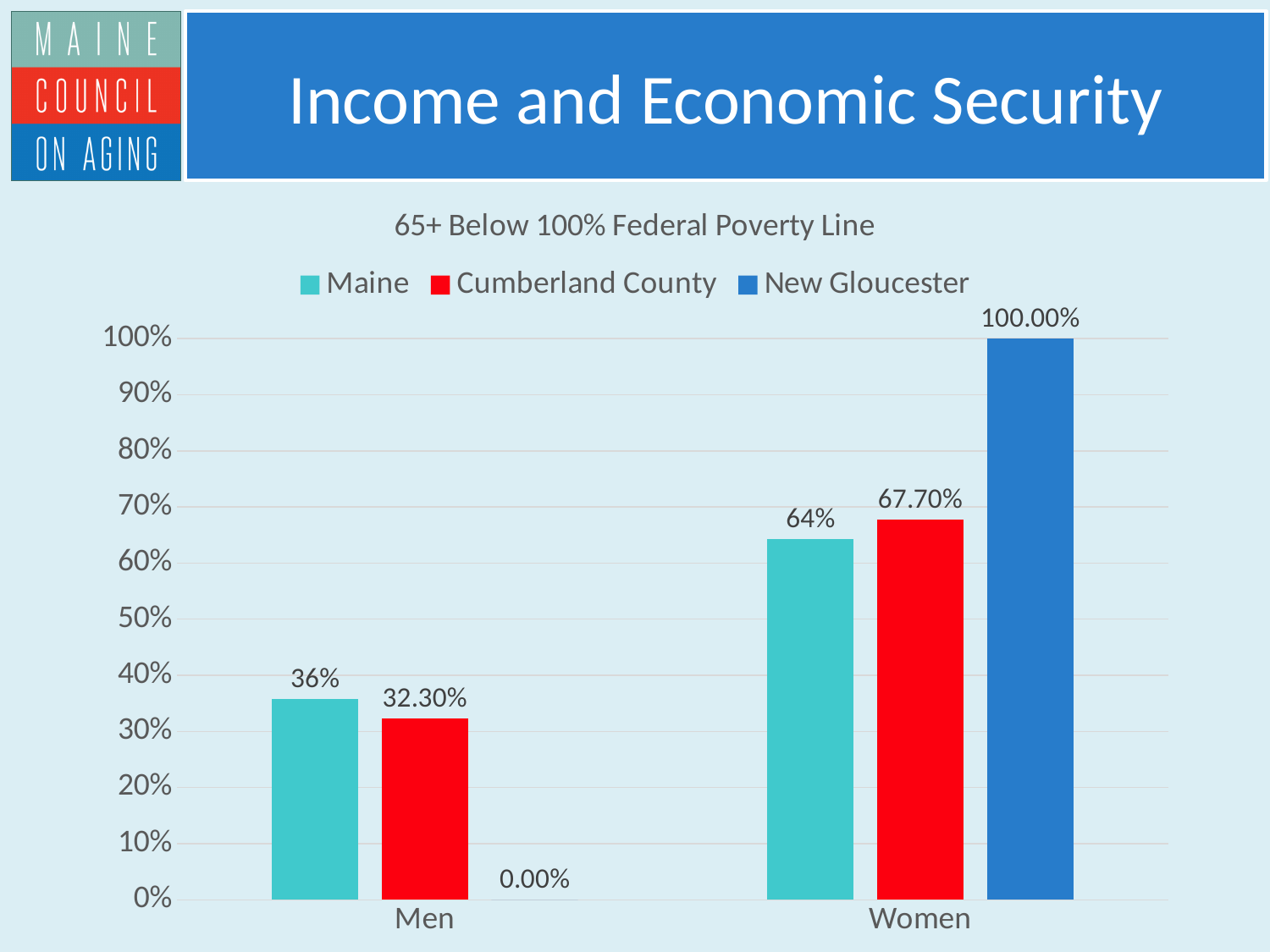
What is the value for Cumberland County in the Women category? 67.70% What is the title of the chart? 65+ Below 100% Federal Poverty Line Which series has the lowest value in the Men category? New Gloucester Which series has the highest value in the Women category? New Gloucester What is the value for New Gloucester in the Women category? 100.00% How many categories are shown on the x axis? 2 What is the value for Maine in the Men category? 36% What is the value for New Gloucester in the Men category? 0.00% What is the difference between the Cumberland County values for Women and Men? 35.40% Which is larger in the Men category, Maine or Cumberland County? Maine What kind of chart is shown on the slide? Bar chart How many series does the legend list? 3